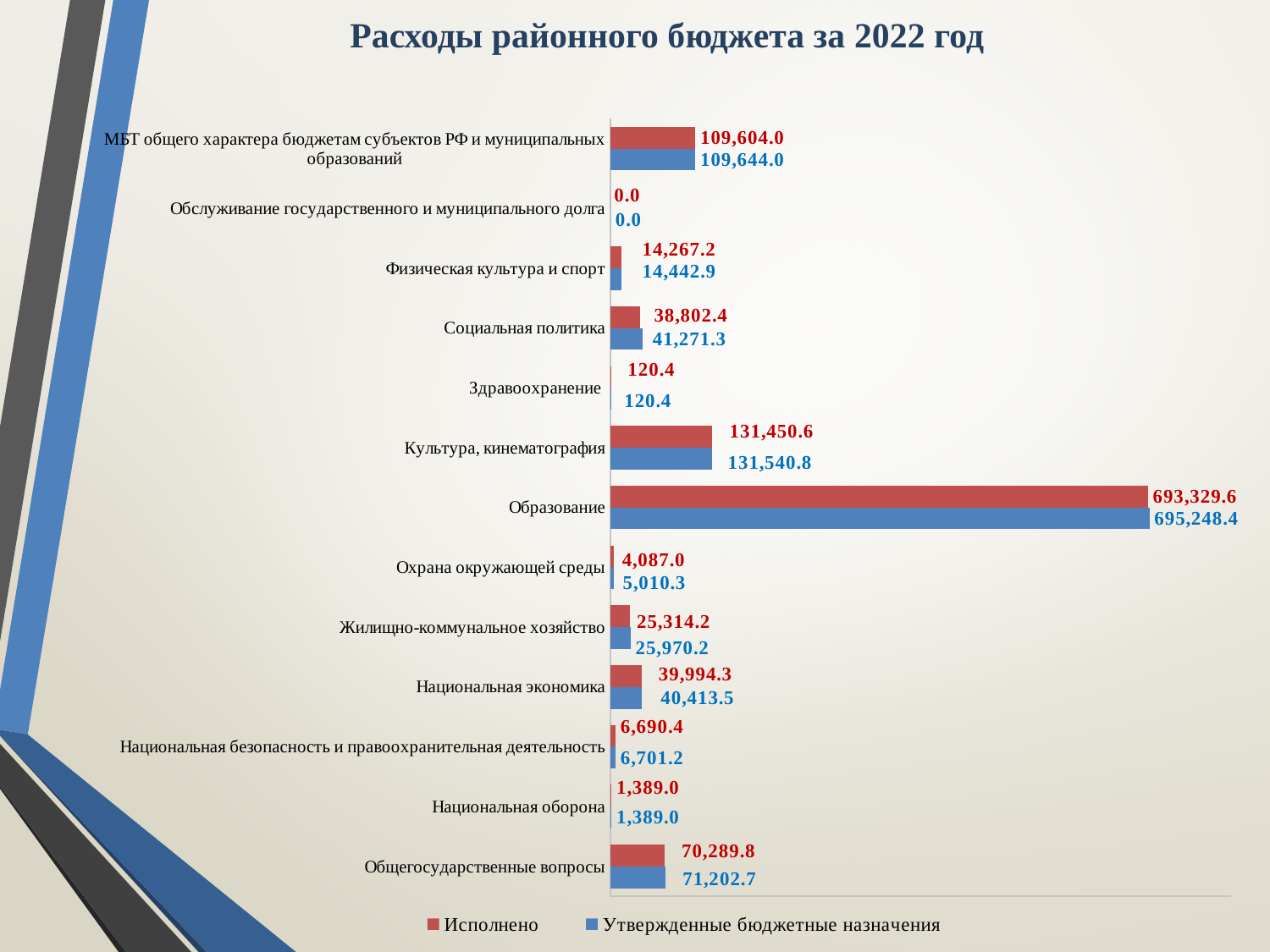
What is the Утвержденные бюджетные назначения value for Социальная политика? 41,271.3 What is the title of the chart? Расходы районного бюджета за 2022 год What is the difference between the Утвержденные бюджетные назначения and Исполнено values for Социальная политика? 2,468.9 What is the Исполнено value for Образование? 693,329.6 Which category has the highest Исполнено value? Образование How many series does the legend list? 2 Which category has the lowest Утвержденные бюджетные назначения value? Обслуживание государственного и муниципального долга What is the Исполнено value for Общегосударственные вопросы? 70,289.8 Which is larger: the Исполнено value for Культура, кинематография or the Исполнено value for МБТ общего характера бюджетам субъектов РФ и муниципальных образований? Культура, кинематография What is the difference between the Утвержденные бюджетные назначения and Исполнено values for Образование? 1,918.8 What type of chart is shown on the slide? Bar chart How many categories are shown on the chart? 13